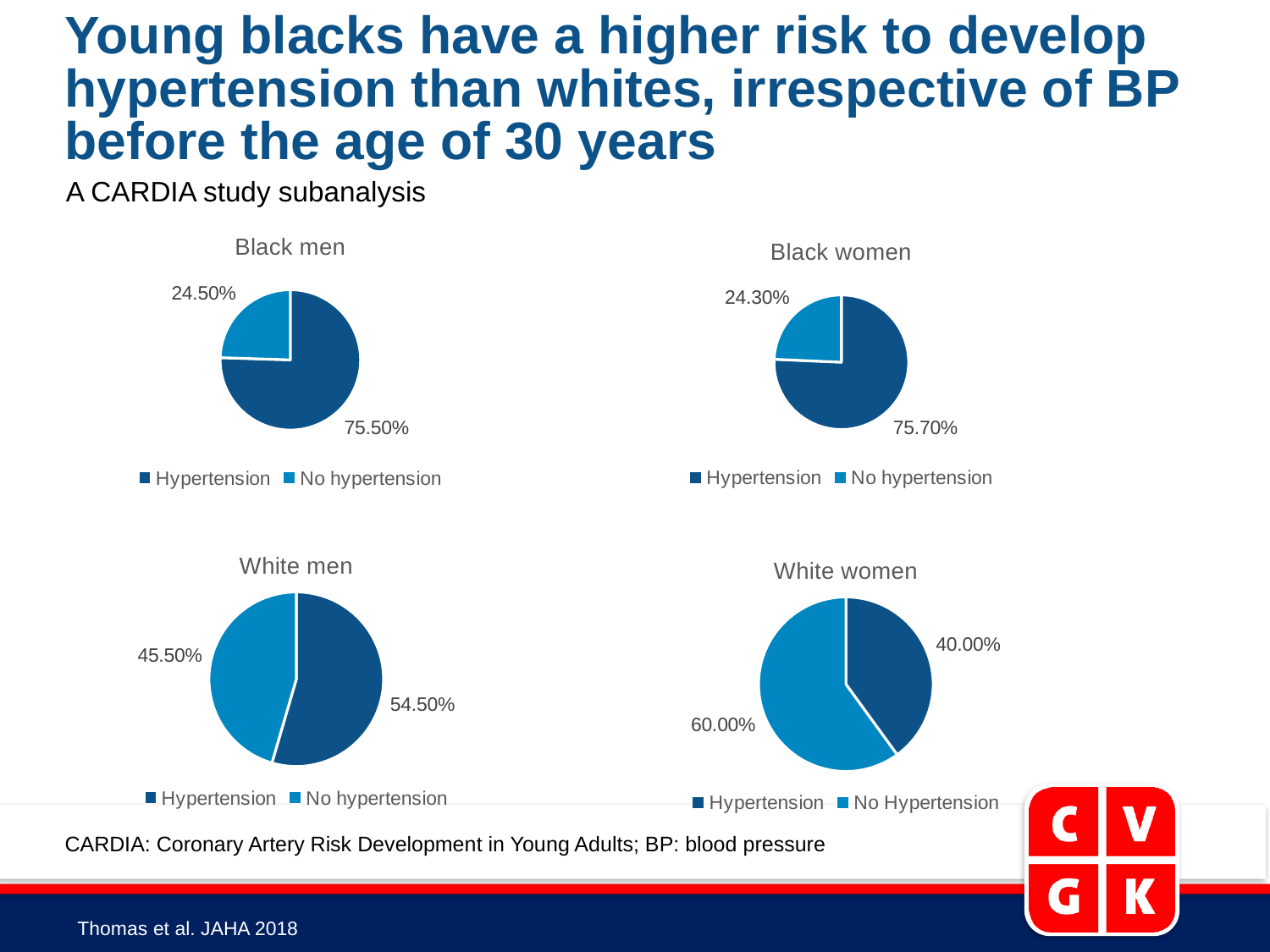
In the Black women chart, is the Hypertension share greater or less than 50%? greater In the White women chart, what is the value for Hypertension? 40.00% What kind of chart is the Black women chart? Pie chart How many entries does the legend of the Black men chart list? 2 In the Black men chart, what share of the pie is Hypertension? 75.50% In the Black men chart, what is the difference between the Hypertension and No hypertension shares? 51.00% In the Black women chart, what percentage is labelled for No hypertension? 24.30% In the White men chart, what is the value for No hypertension? 45.50% In the White men chart, which slice is the largest? Hypertension How many pie charts are shown on the slide? 4 In the White women chart, which slice is larger, Hypertension or No Hypertension? No Hypertension In the White men chart, what is the difference between the Hypertension and No hypertension shares? 9.00%